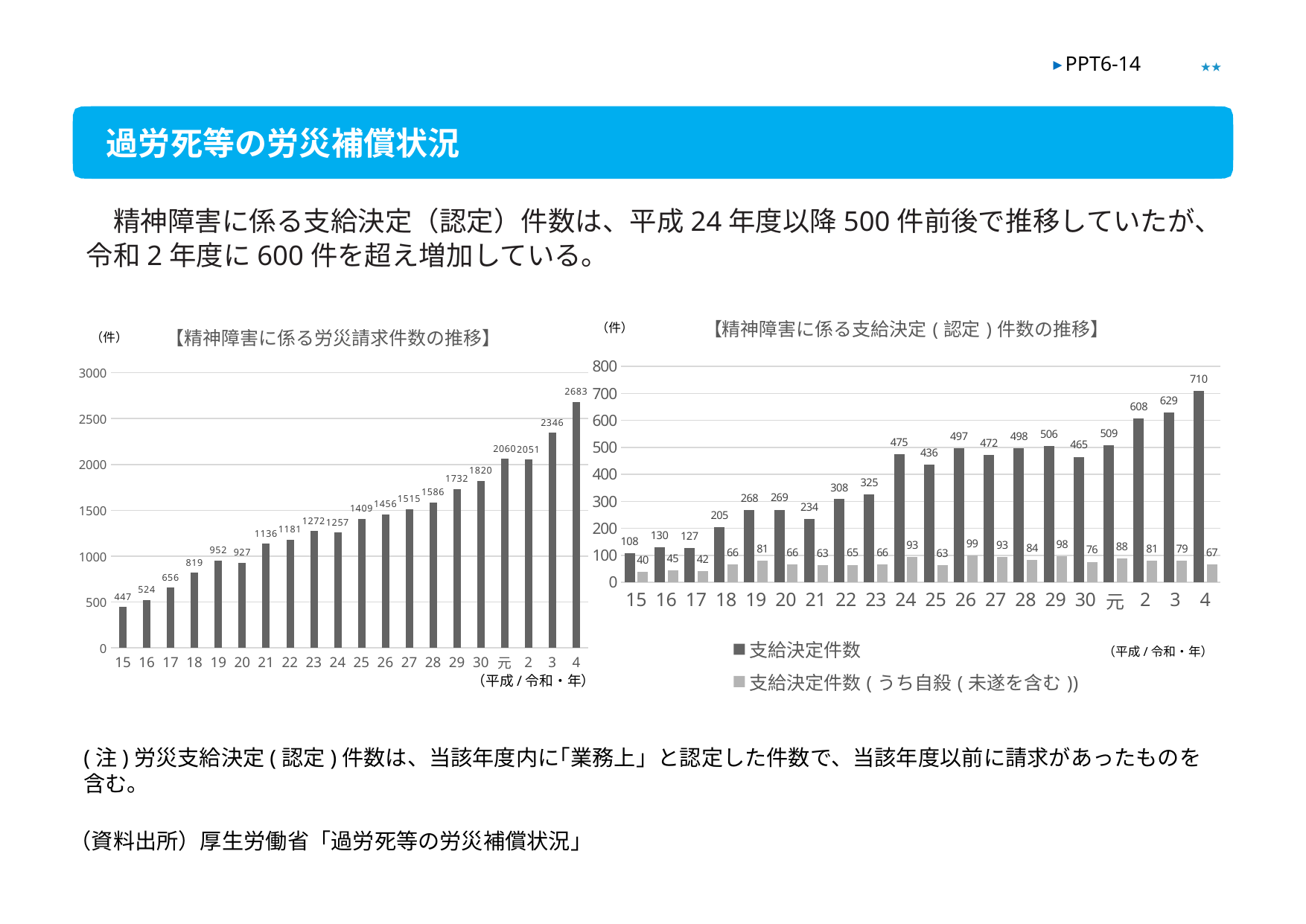
In the left chart (精神障害に係る労災請求件数の推移), which year has the highest value? 4 (令和4年) In the left chart (精神障害に係る労災請求件数の推移), what is the value for 平成15年? 447 In the right chart (精神障害に係る支給決定(認定)件数の推移), which is larger: the 支給決定件数 for 平成24年 or for 平成25年? 平成24年 (475) What kind of chart is the left chart (精神障害に係る労災請求件数の推移)? Bar chart In the right chart (精神障害に係る支給決定(認定)件数の推移), what is the 支給決定件数(うち自殺(未遂を含む)) value for 平成26年? 99 In the right chart (精神障害に係る支給決定(認定)件数の推移), which year has the lowest 支給決定件数? 15 (平成15年) In the left chart (精神障害に係る労災請求件数の推移), what is the value for 令和4年? 2683 In the right chart (精神障害に係る支給決定(認定)件数の推移), how many series does the legend list? 2 In the right chart (精神障害に係る支給決定(認定)件数の推移), what is the difference between the 支給決定件数 for 令和4年 and 令和3年? 81 In the left chart (精神障害に係る労災請求件数の推移), how many years are plotted? 20 In the left chart (精神障害に係る労災請求件数の推移), what is the difference between the values for 令和4年 and 令和3年? 337 In the right chart (精神障害に係る支給決定(認定)件数の推移), what is the 支給決定件数 value for 令和2年? 608